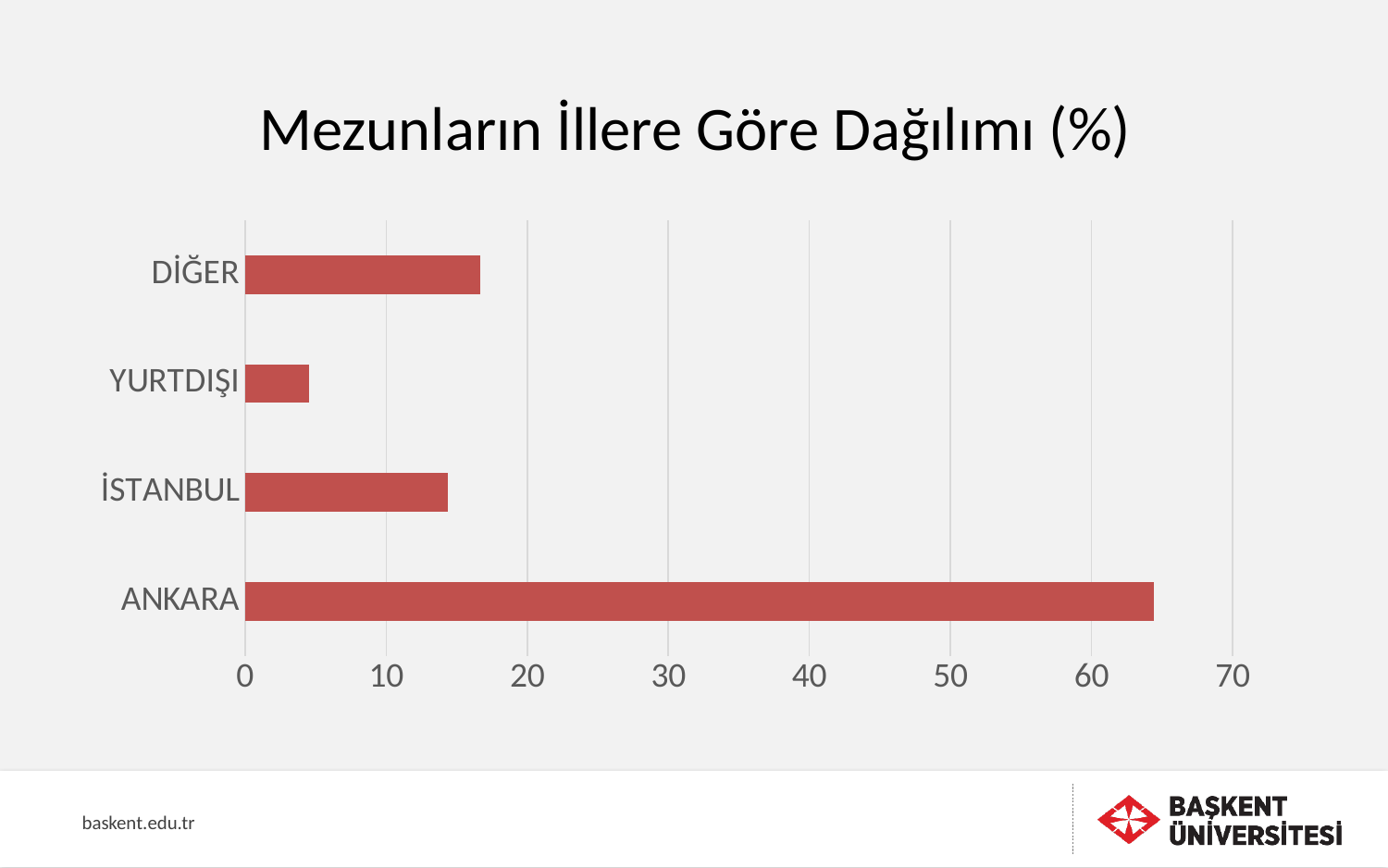
Is the value for İSTANBUL greater or less than 20? less How many categories are shown in the chart? 4 Which category has the highest value? ANKARA Which is larger, the value for DİĞER or the value for YURTDIŞI? DİĞER Which category has the lowest value? YURTDIŞI Is the value for ANKARA greater or less than 60? greater What is the highest value shown on the horizontal axis? 70 What is the title of the chart? Mezunların İllere Göre Dağılımı (%) Which is larger, the value for ANKARA or the value for İSTANBUL? ANKARA Is the value for DİĞER greater or less than 10? greater What kind of chart is shown on the slide? bar chart